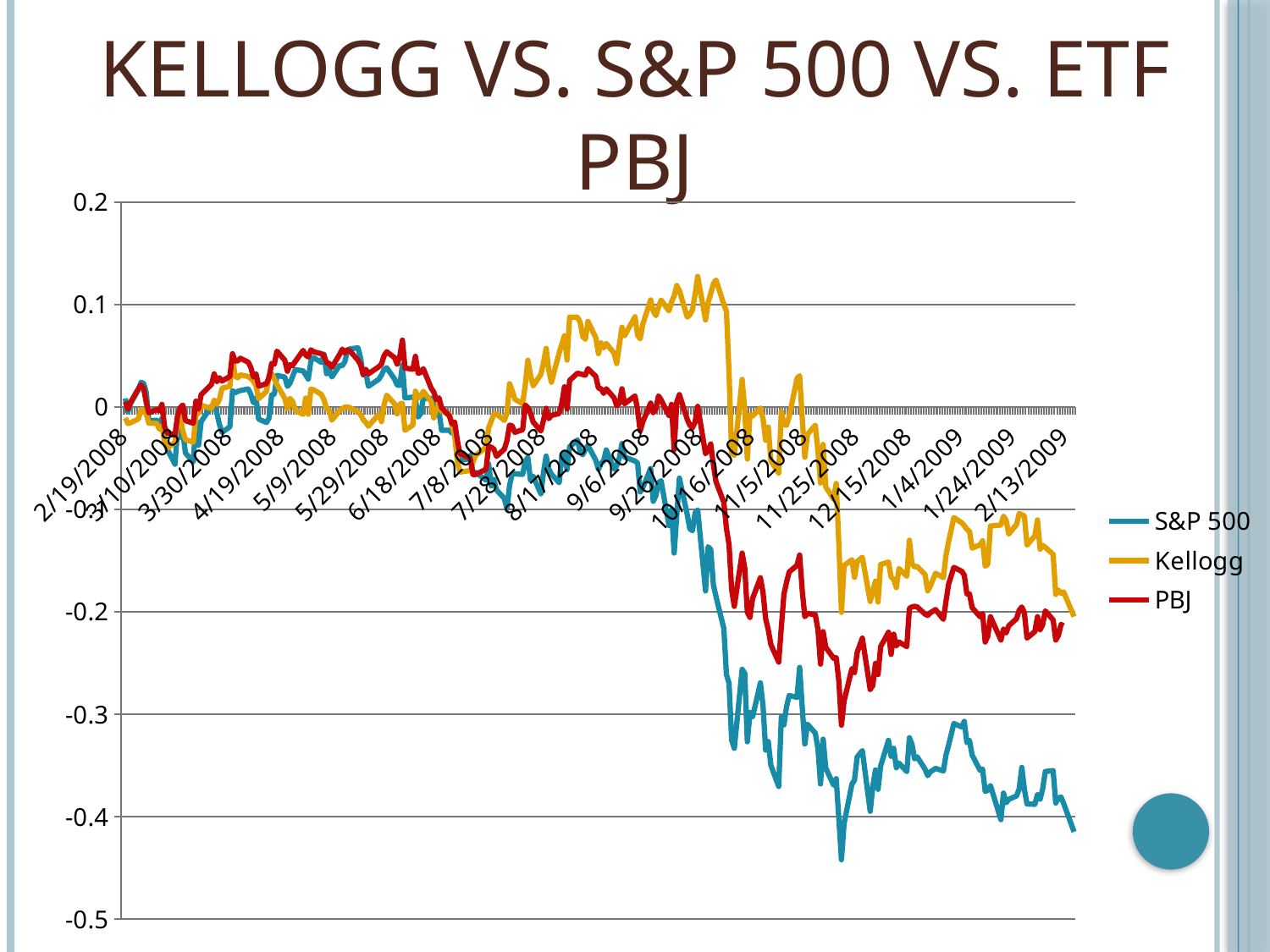
Which series is drawn in red? PBJ Which series has the lowest value at the right end of the chart (2/13/2009)? S&P 500 What kind of chart is shown on the slide? line chart At 2/13/2009, which is larger: the value for Kellogg or the value for S&P 500? Kellogg Is the value for S&P 500 at 2/13/2009 greater or less than -0.3? less Which series reaches the highest value on the chart? Kellogg What is the title of the chart? KELLOGG VS. S&P 500 VS. ETF PBJ How many series does the legend list? 3 Is the lowest value of S&P 500 greater or less than -0.4? less Does the S&P 500 series rise or fall between 9/26/2008 and 11/25/2008? fall Which series reaches the lowest value on the chart? S&P 500 Is the peak value of Kellogg greater or less than 0.1? greater